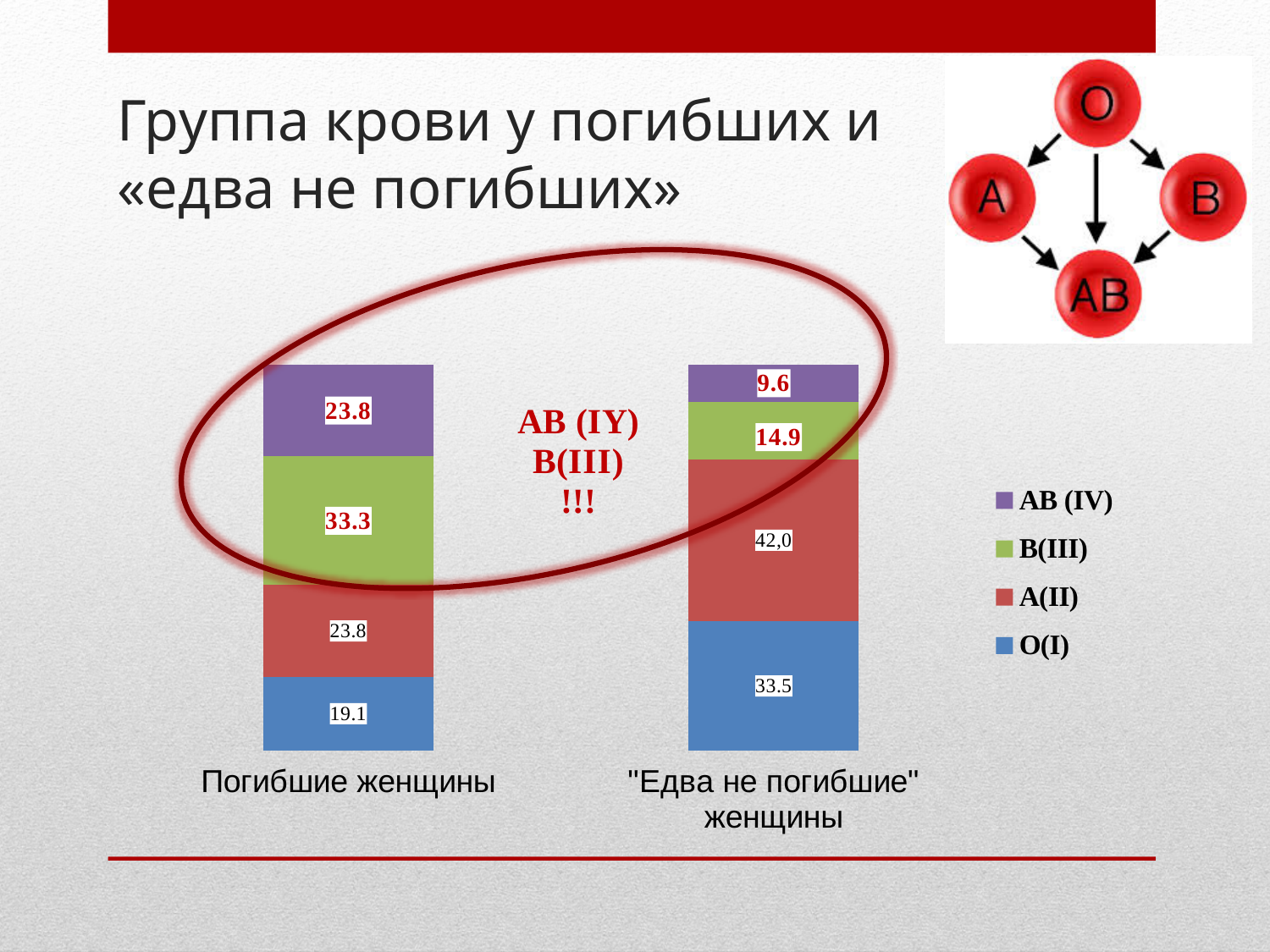
Which blood group has the smallest segment in the "Едва не погибшие" женщины bar? AB (IV) What kind of chart is shown on the slide? Stacked bar chart Which bar has the larger O(I) value, "Погибшие женщины" or "Едва не погибшие" женщины? "Едва не погибшие" женщины What is the total of the "Погибшие женщины" stacked bar? 100.0 What is the value for A(II) in the "Едва не погибшие" женщины bar? 42,0 What is the value for AB (IV) in the "Едва не погибшие" женщины bar? 9.6 How many categories (bars) are shown in the chart? 2 What is the value for O(I) in the "Погибшие женщины" bar? 19.1 What is the difference between the AB (IV) values for "Погибшие женщины" and "Едва не погибшие" женщины? 14.2 How many series does the legend list? 4 What is the value for B(III) in the "Погибшие женщины" bar? 33.3 Which blood group has the largest segment in the "Погибшие женщины" bar? B(III)